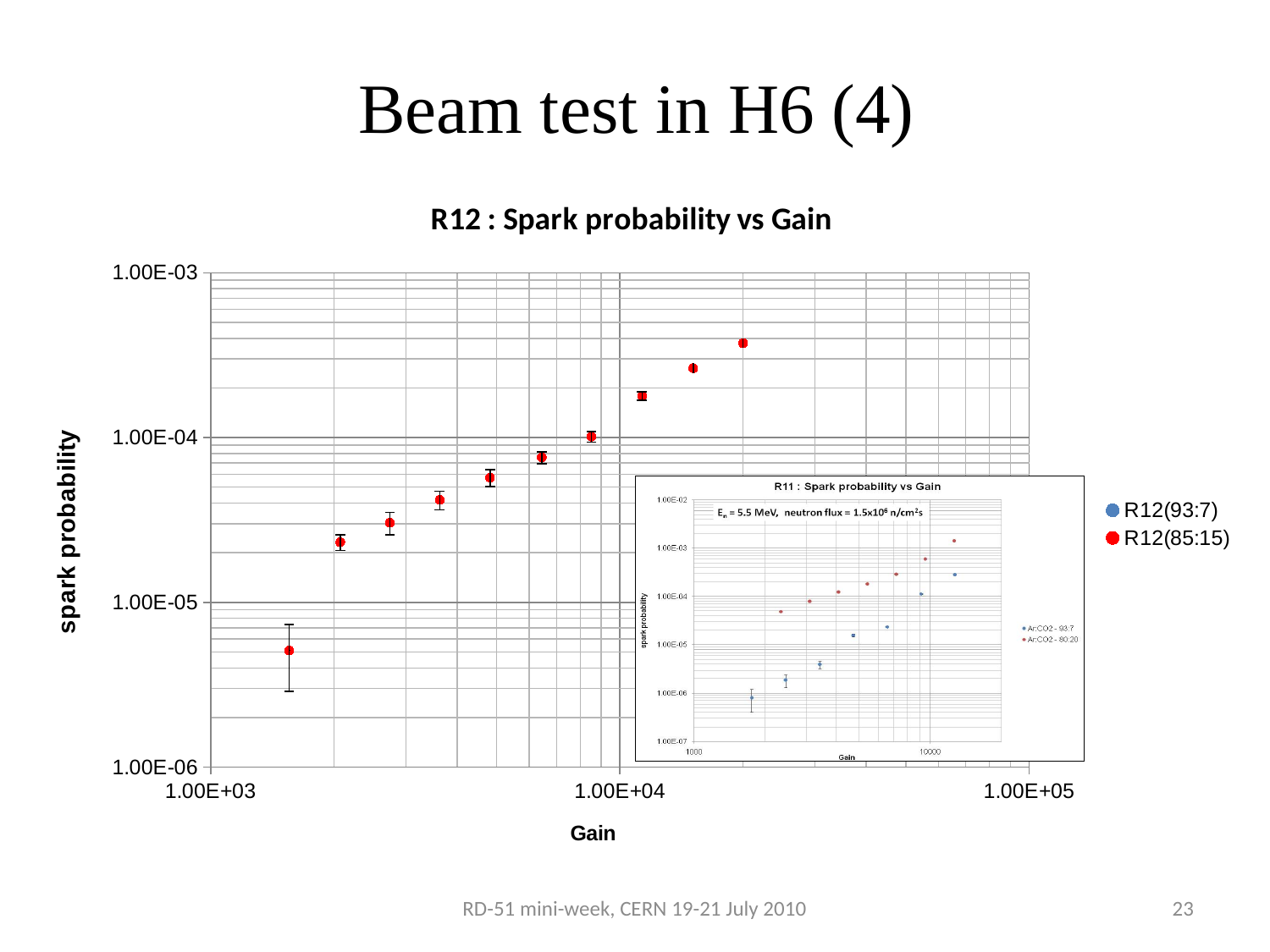
What kind of chart is the main chart titled 'R12 : Spark probability vs Gain'? scatter chart In the main chart 'R12 : Spark probability vs Gain', how many data points are plotted for the R12(85:15) series? 10 In the main chart 'R12 : Spark probability vs Gain', is the spark probability of the highest-gain point greater or less than 1.00E-03? less In the main chart 'R12 : Spark probability vs Gain', is the spark probability of the lowest-gain point greater or less than 1.00E-05? less In the main chart 'R12 : Spark probability vs Gain', how many series does the legend list? 2 What are the two legend entries in the main chart 'R12 : Spark probability vs Gain'? R12(93:7) and R12(85:15) In the main chart 'R12 : Spark probability vs Gain', is the spark probability of the highest-gain point greater or less than 1.00E-04? greater In the main chart 'R12 : Spark probability vs Gain', does the spark probability rise or fall as Gain increases? rise What is the title of the main chart on the slide? R12 : Spark probability vs Gain